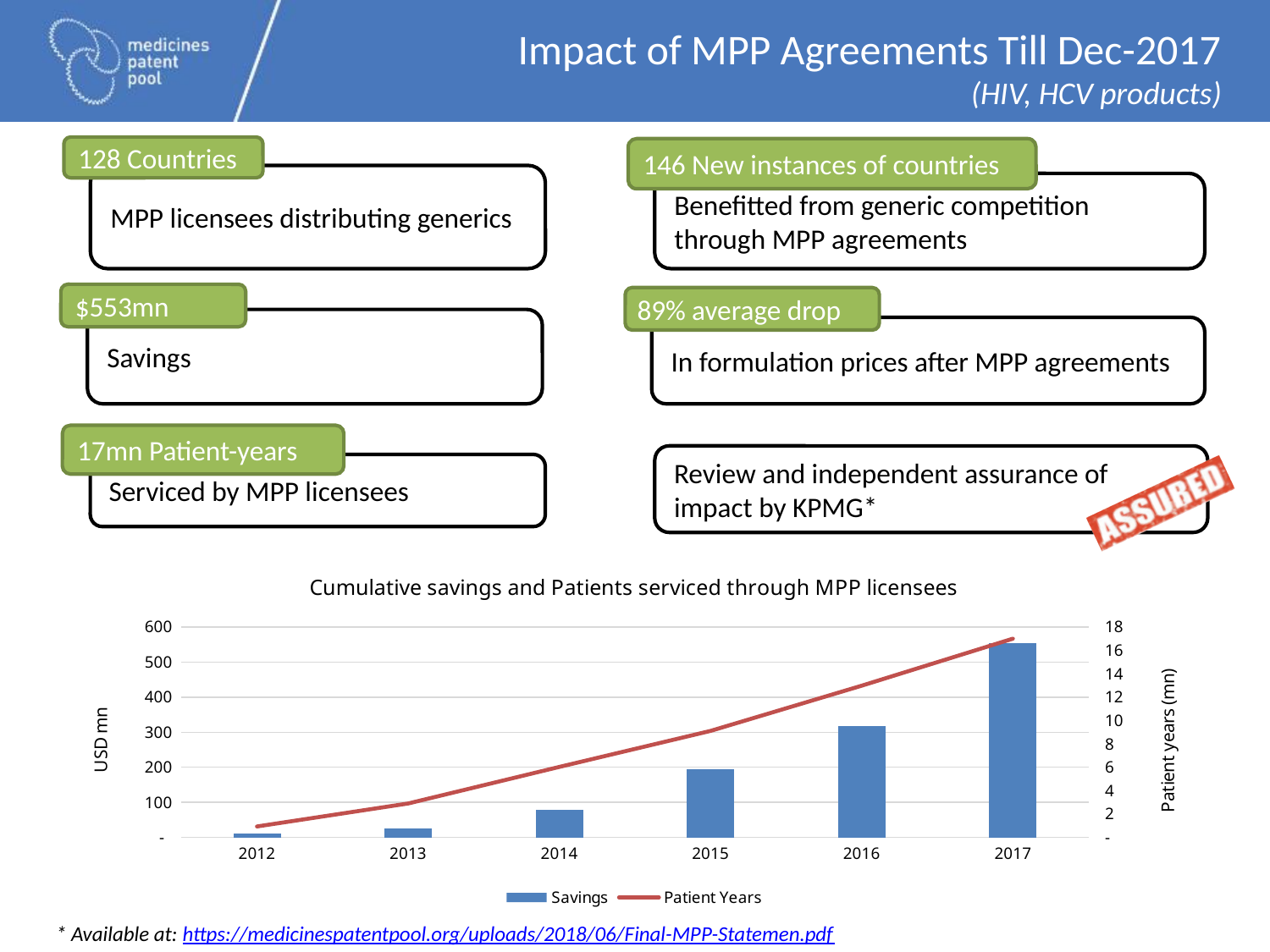
Which year has the highest Savings bar? 2017 What type of chart is shown on the slide? Combined bar and line chart Is the Savings value for 2014 greater or less than 100? less Which year has the lowest Savings bar? 2012 Is the Savings value for 2016 greater or less than 400? less Is the Patient Years value for 2017 greater or less than 16? greater What is the title of the chart on the slide? Cumulative savings and Patients serviced through MPP licensees How many series does the chart legend list? 2 Which is larger, the Savings value for 2015 or for 2016? 2016 Do the Savings values rise or fall from 2012 to 2017? rise How many years are shown on the x axis of the chart? 6